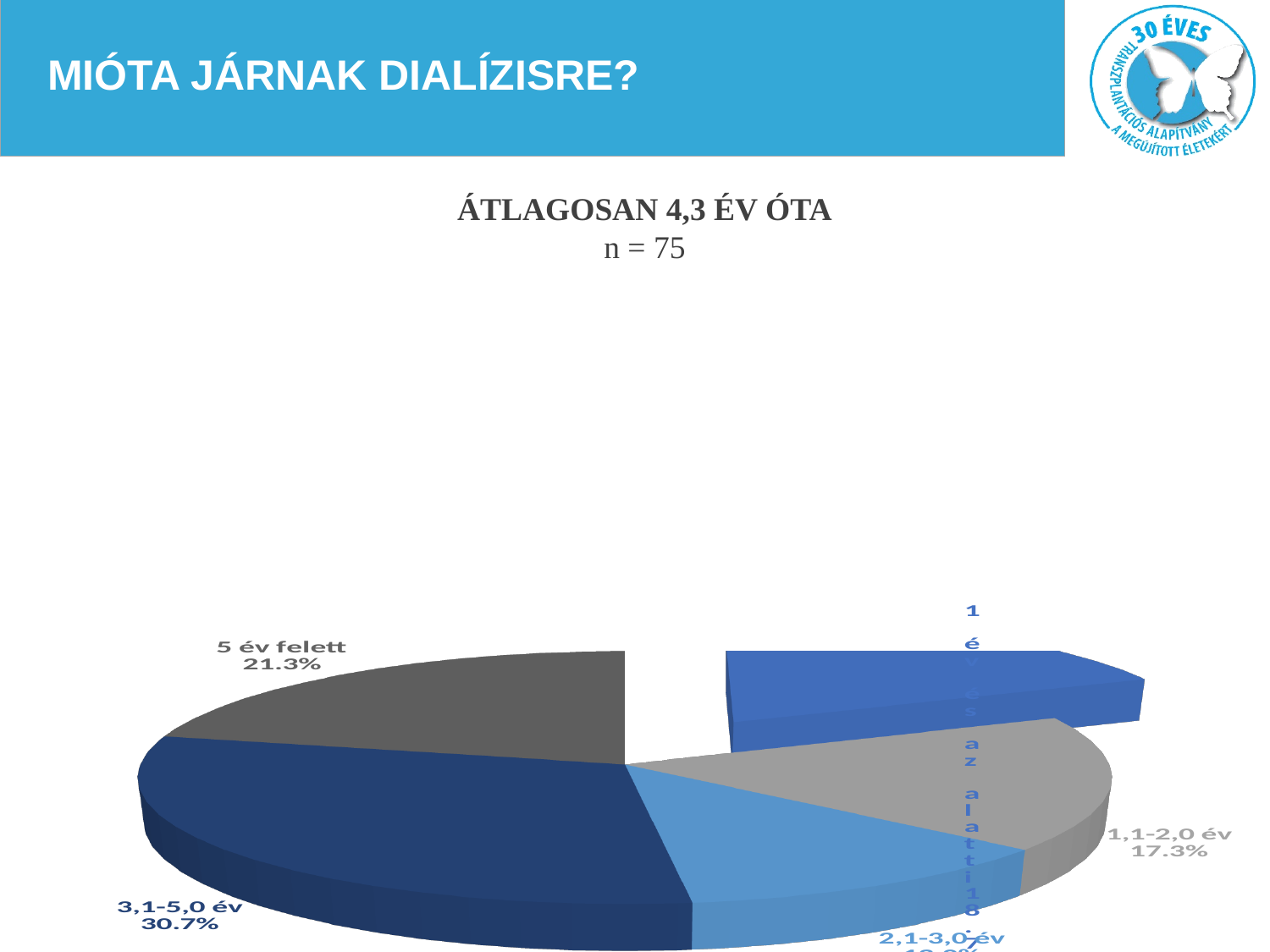
What sample size (n) is stated on the slide? n = 75 What percentage is shown for the '1,1-2,0 év' slice? 17.3% What kind of chart is shown on the slide? pie chart What percentage of respondents have been on dialysis for 3,1-5,0 év? 30.7% What average duration of dialysis is stated on the slide? 4,3 év What is the difference in percentage points between the '3,1-5,0 év' and '5 év felett' slices? 9.4 What percentage is shown for the '5 év felett' slice? 21.3% How many slices does the pie chart have? 5 Which is larger: the share for '3,1-5,0 év' or for '5 év felett'? 3,1-5,0 év Which is larger: the share for '5 év felett' or for '1,1-2,0 év'? 5 év felett Which category has the largest share of the pie? 3,1-5,0 év What is the difference in percentage points between the '5 év felett' and '1,1-2,0 év' slices? 4.0